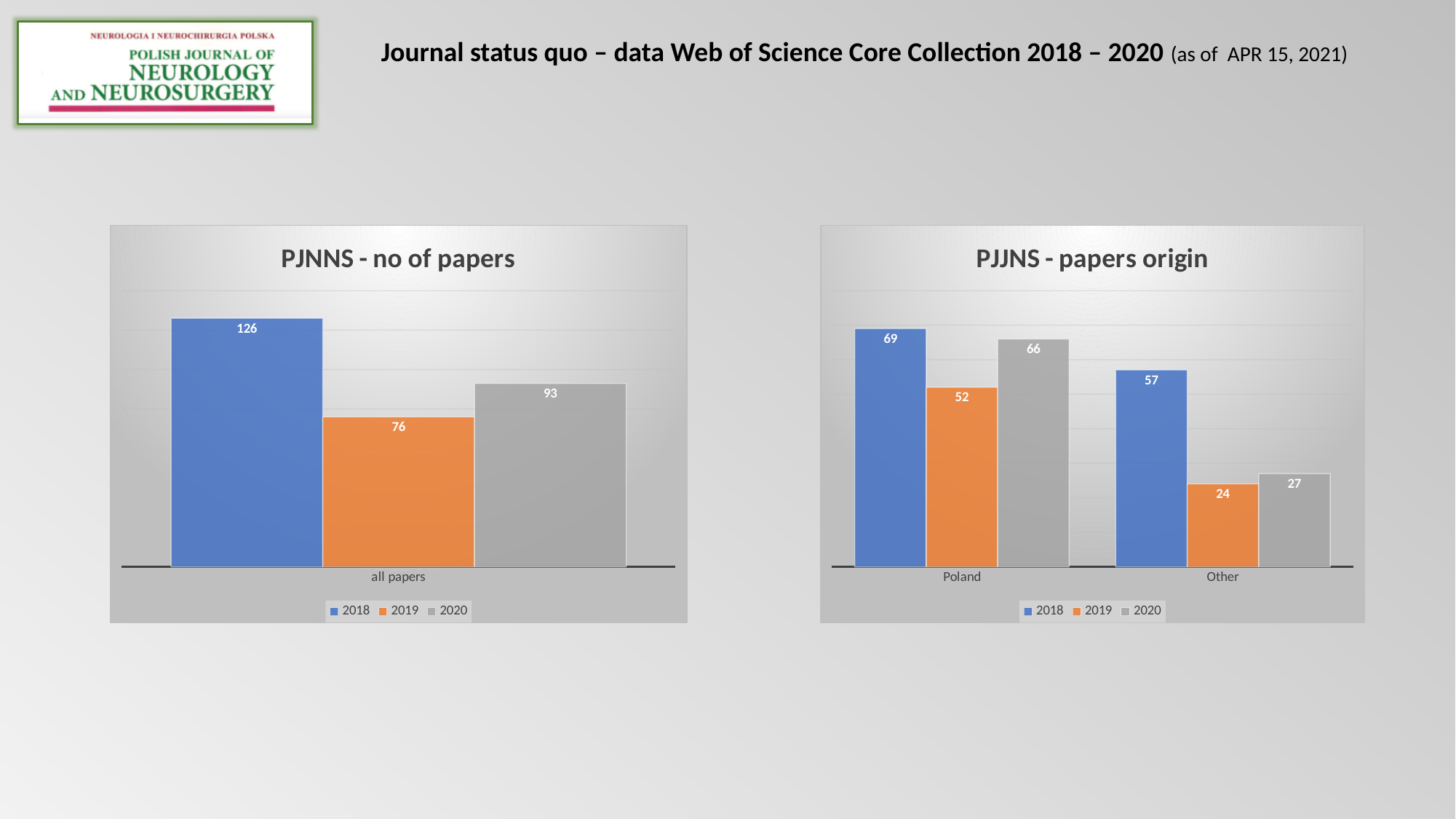
In the 'PJJNS - papers origin' chart, which colour represents 2019? orange In the 'PJJNS - papers origin' chart, what is the difference between Poland and Other in 2020? 39 How many categories are shown on the x axis of the 'PJJNS - papers origin' chart? 2 What kind of chart is the 'PJJNS - papers origin' chart? bar chart In the 'PJJNS - papers origin' chart, what is the value for Poland in 2019? 52 In the 'PJJNS - papers origin' chart, what is the value for Other in 2020? 27 In the 'PJJNS - papers origin' chart, which is larger: Other in 2018 or Poland in 2019? Other in 2018 In the 'PJJNS - papers origin' chart, which year has the highest value for Poland? 2018 In the 'PJNNS - no of papers' chart, what is the difference between the 2018 and 2020 values? 33 In the 'PJNNS - no of papers' chart, how many series does the legend list? 3 In the 'PJNNS - no of papers' chart, which year has the lowest number of papers? 2019 In the 'PJNNS - no of papers' chart, what is the value for 2018? 126